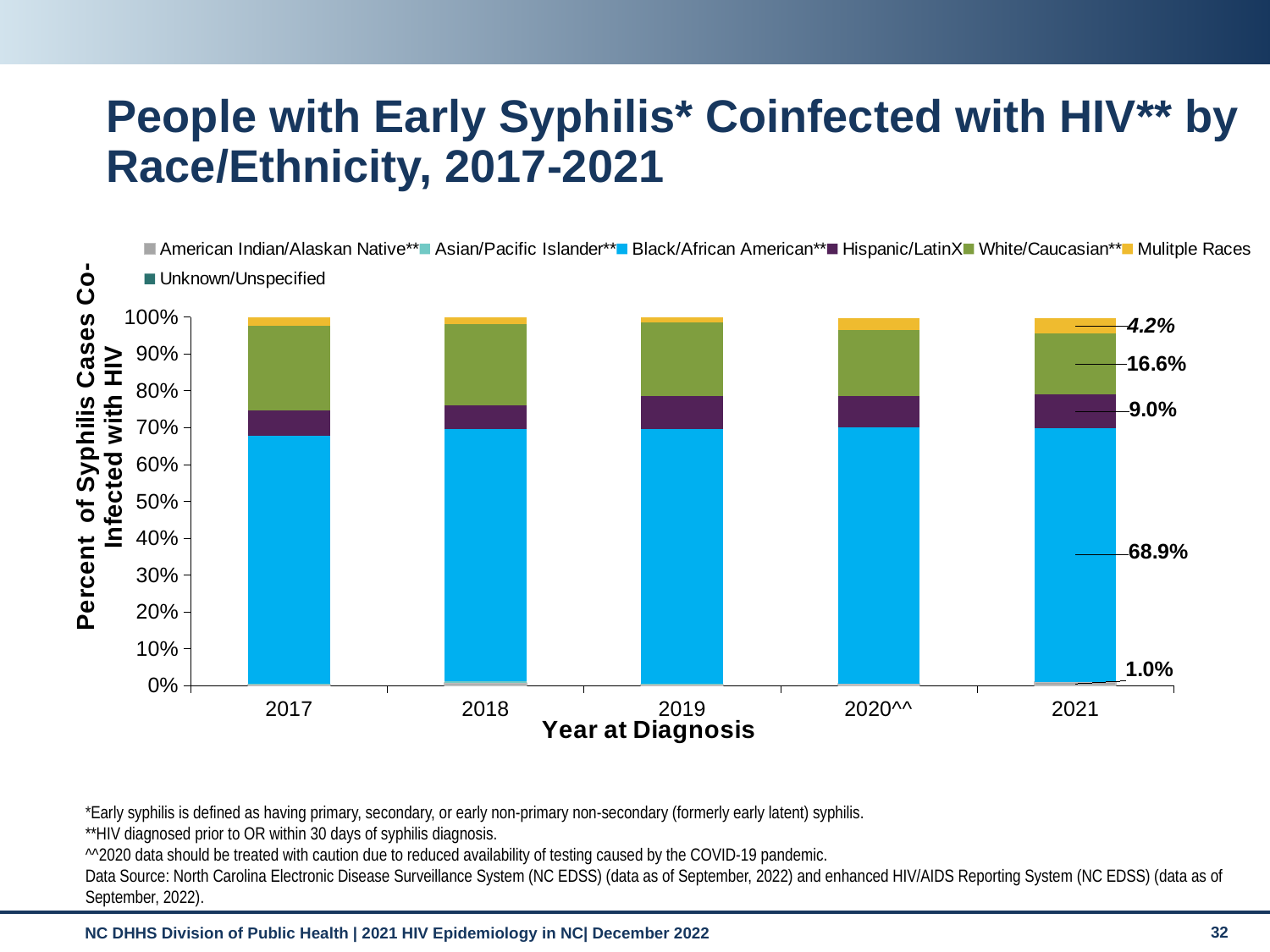
How many years are shown on the x axis of the chart? 5 In 2021, how many percentage points higher is the Black/African American share than the White/Caucasian share? 52.3 percentage points Is the Black/African American share in 2017 greater or less than 60%? greater What is the labeled value for Hispanic/LatinX in 2021? 9.0% In 2021, which is larger: the White/Caucasian share or the Hispanic/LatinX share? White/Caucasian In 2021, which labeled race/ethnicity group has the largest share? Black/African American What is the title of the x axis? Year at Diagnosis How many race/ethnicity series does the legend list? 7 What is the labeled value for Multiple Races in 2021? 4.2% What percentage of early syphilis cases co-infected with HIV in 2021 were Black/African American? 68.9% What kind of chart is shown on the slide? Stacked bar chart What is the labeled value for White/Caucasian in 2021? 16.6%